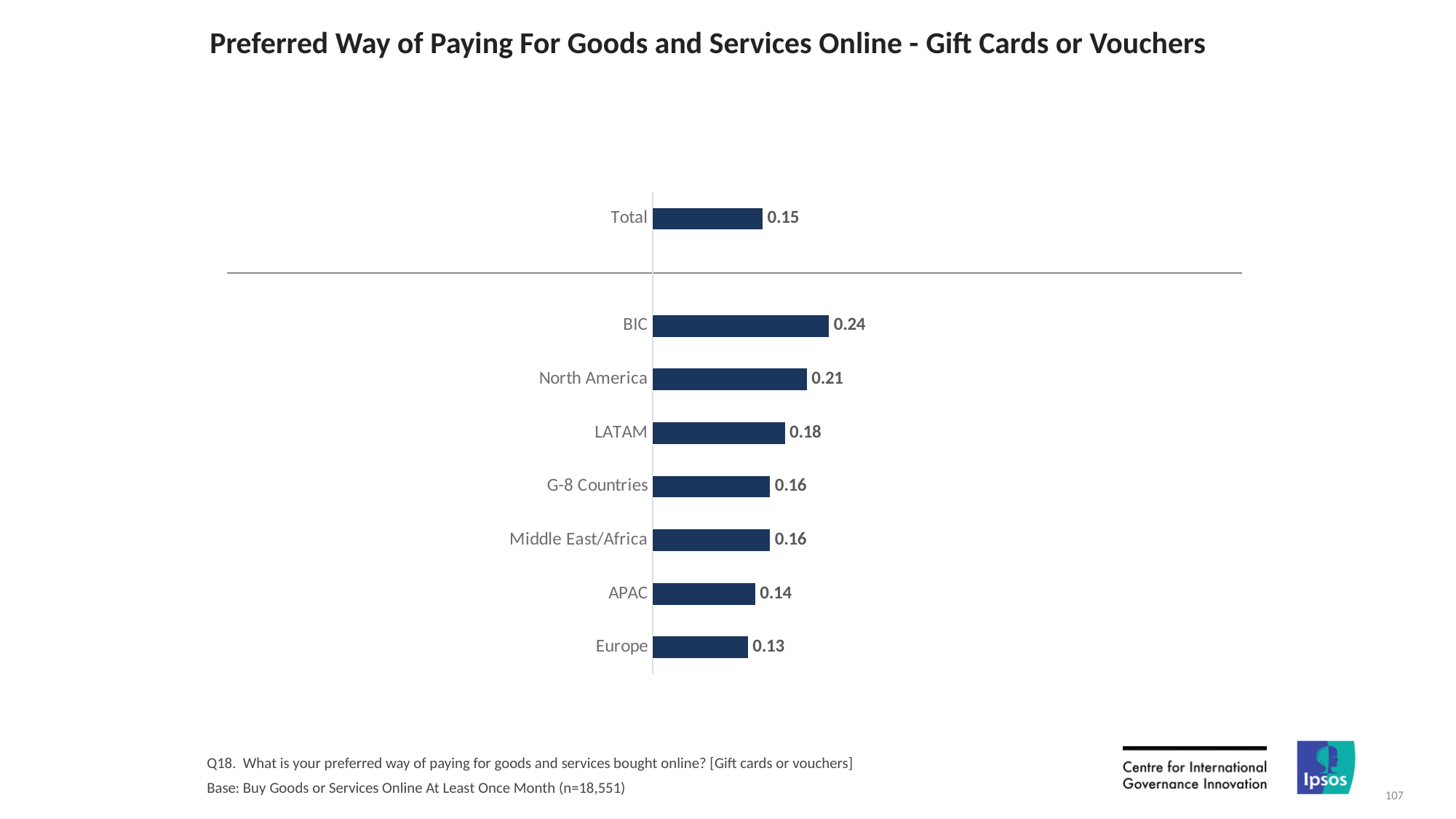
What is the difference between the values for North America and LATAM? 0.03 Which region has the highest value? BIC What is the value for North America? 0.21 What is the value for BIC? 0.24 How many bars are shown on the chart, including Total? 8 What is the value for Total? 0.15 What kind of chart is shown on the slide? Bar chart Which region has the lowest value? Europe What is the value for Europe? 0.13 Which is larger, the value for LATAM or the value for APAC? LATAM What is the difference between the values for BIC and Europe? 0.11 What is the title of the chart? Preferred Way of Paying For Goods and Services Online - Gift Cards or Vouchers